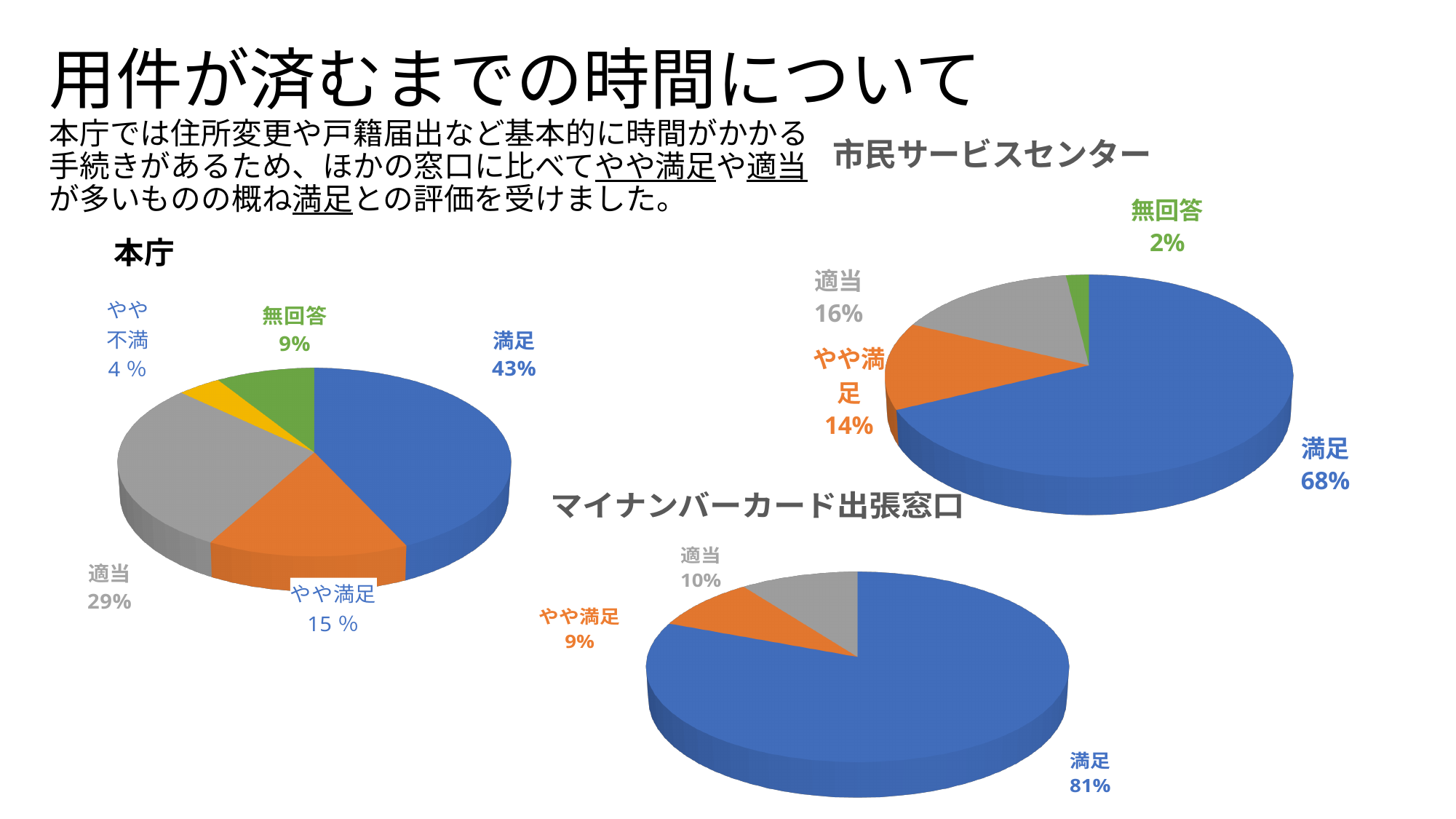
In the 市民サービスセンター chart, what is the difference between the 満足 and 適当 shares? 52 percentage points In the マイナンバーカード出張窓口 chart, which is larger, 適当 or やや満足? 適当 How many slices does the マイナンバーカード出張窓口 pie chart have? 3 In the 市民サービスセンター chart, what share is labelled 無回答? 2% In the 本庁 chart, what share is labelled 適当? 29% What type of chart is used for 市民サービスセンター? Pie chart In the 本庁 chart, what share is labelled やや不満? 4 % In the 本庁 chart, which category has the smallest slice? やや不満 In the 市民サービスセンター chart, what share is labelled やや満足? 14% How many slices does the 本庁 pie chart have? 5 In the 本庁 chart, what share is labelled 満足? 43% In the マイナンバーカード出張窓口 chart, what share is labelled 満足? 81%